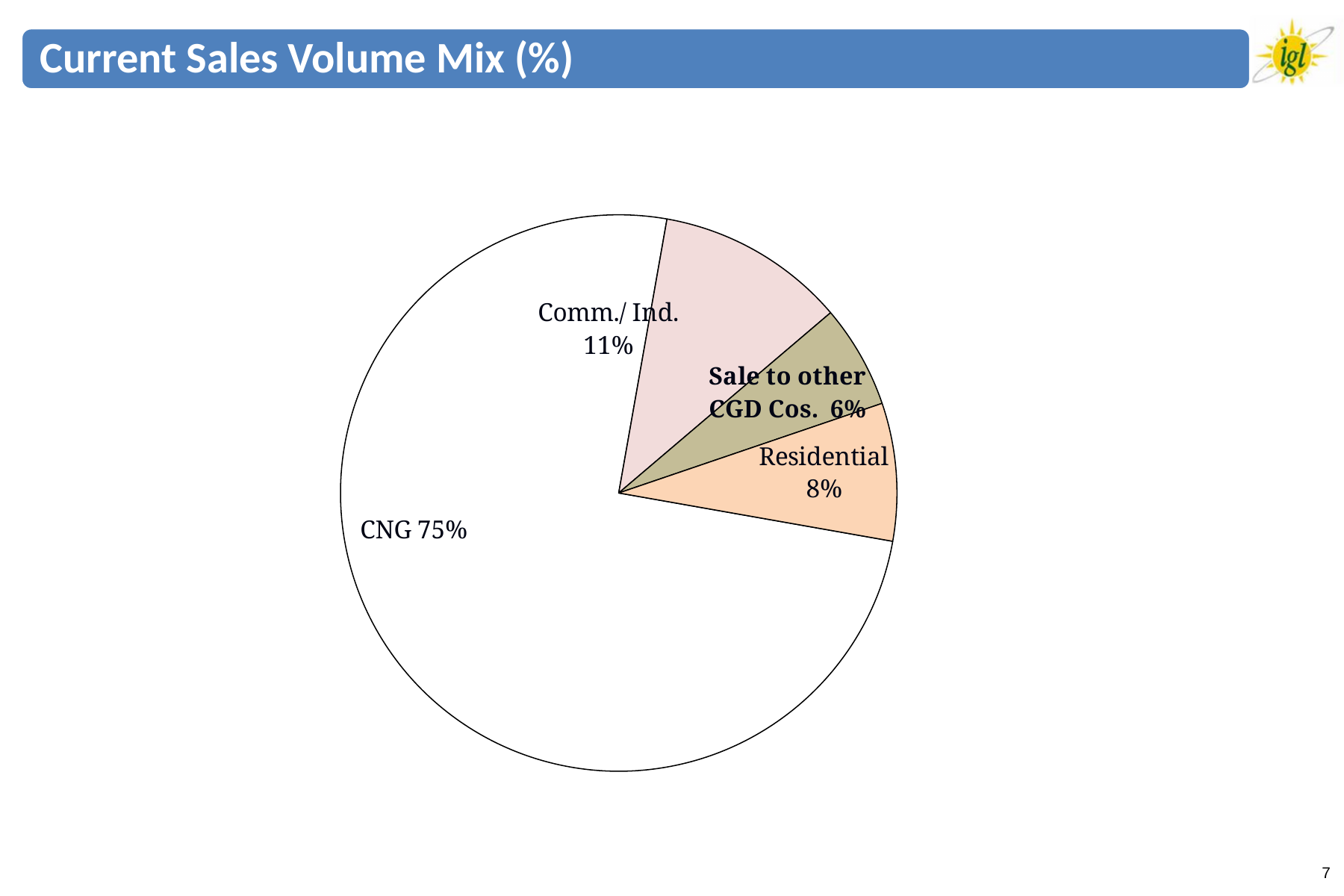
What share of the sales volume mix is CNG? 75% What is the difference in percentage points between the CNG share and the Comm./ Ind. share? 64 Which segment has the largest share of the sales volume mix? CNG What kind of chart is shown on the slide? Pie chart What is the title of the slide? Current Sales Volume Mix (%) How many segments does the pie chart show? 4 What share of the sales volume mix is Residential? 8% Which segment has the smallest share of the sales volume mix? Sale to other CGD Cos. What share of the sales volume mix is Comm./ Ind.? 11% What is the difference in percentage points between the Residential share and the Sale to other CGD Cos. share? 2 Which has a larger share, Comm./ Ind. or Residential? Comm./ Ind. What share of the sales volume mix is Sale to other CGD Cos.? 6%